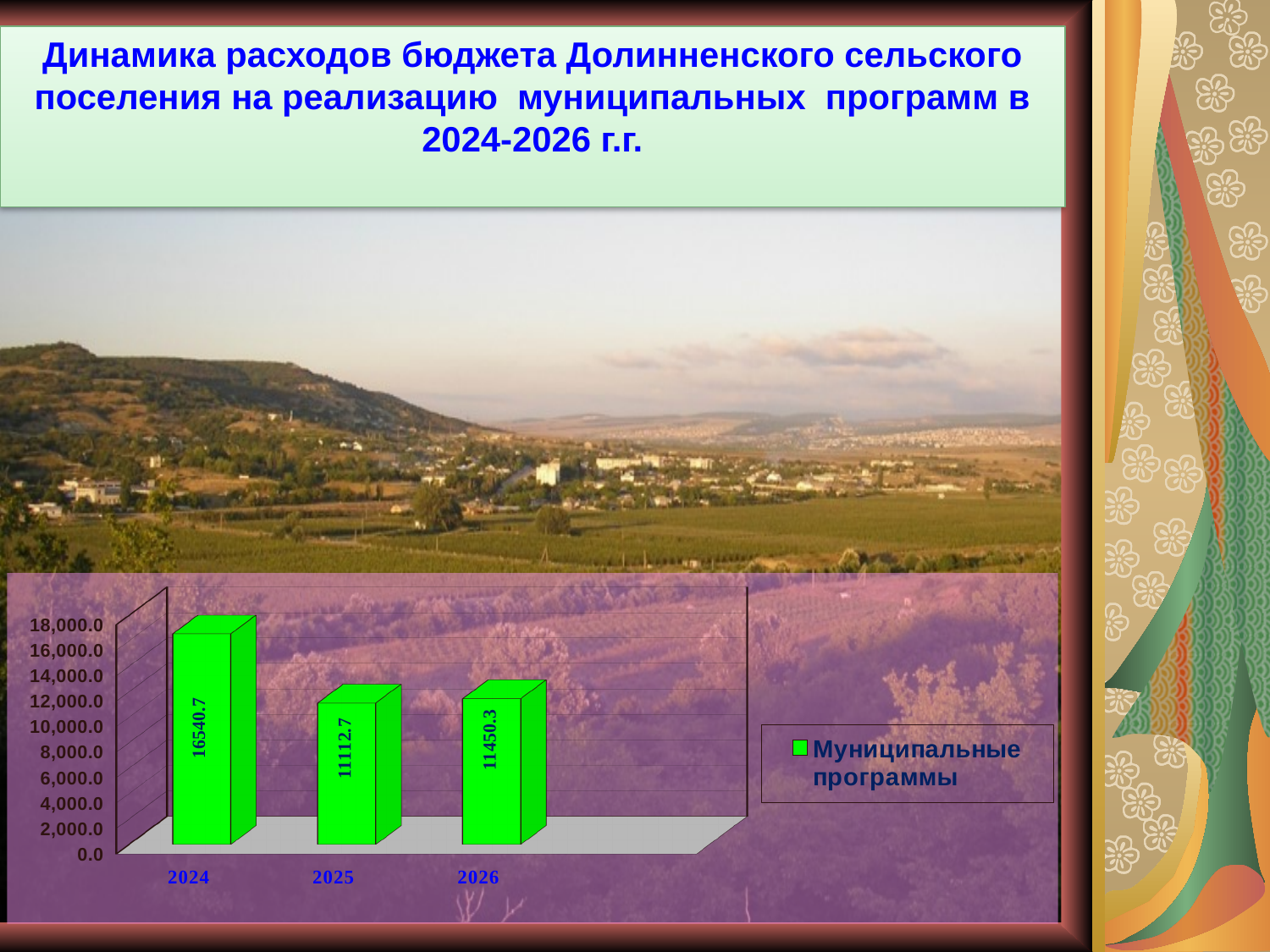
Is the value for 2024 greater or less than 14,000.0? greater How many series does the chart legend list? 1 Which is larger, the value for 2025 or the value for 2026? 2026 What is the value for 2026 in the chart? 11450.3 What is the value for 2024 in the chart? 16540.7 What kind of chart is shown on the slide? bar chart How many years are shown on the x axis of the chart? 3 Which year has the highest value in the chart? 2024 Which year has the lowest value in the chart? 2025 What is the difference between the values for 2024 and 2025? 5428.0 What is the difference between the values for 2026 and 2025? 337.6 What is the value for 2025 in the chart? 11112.7